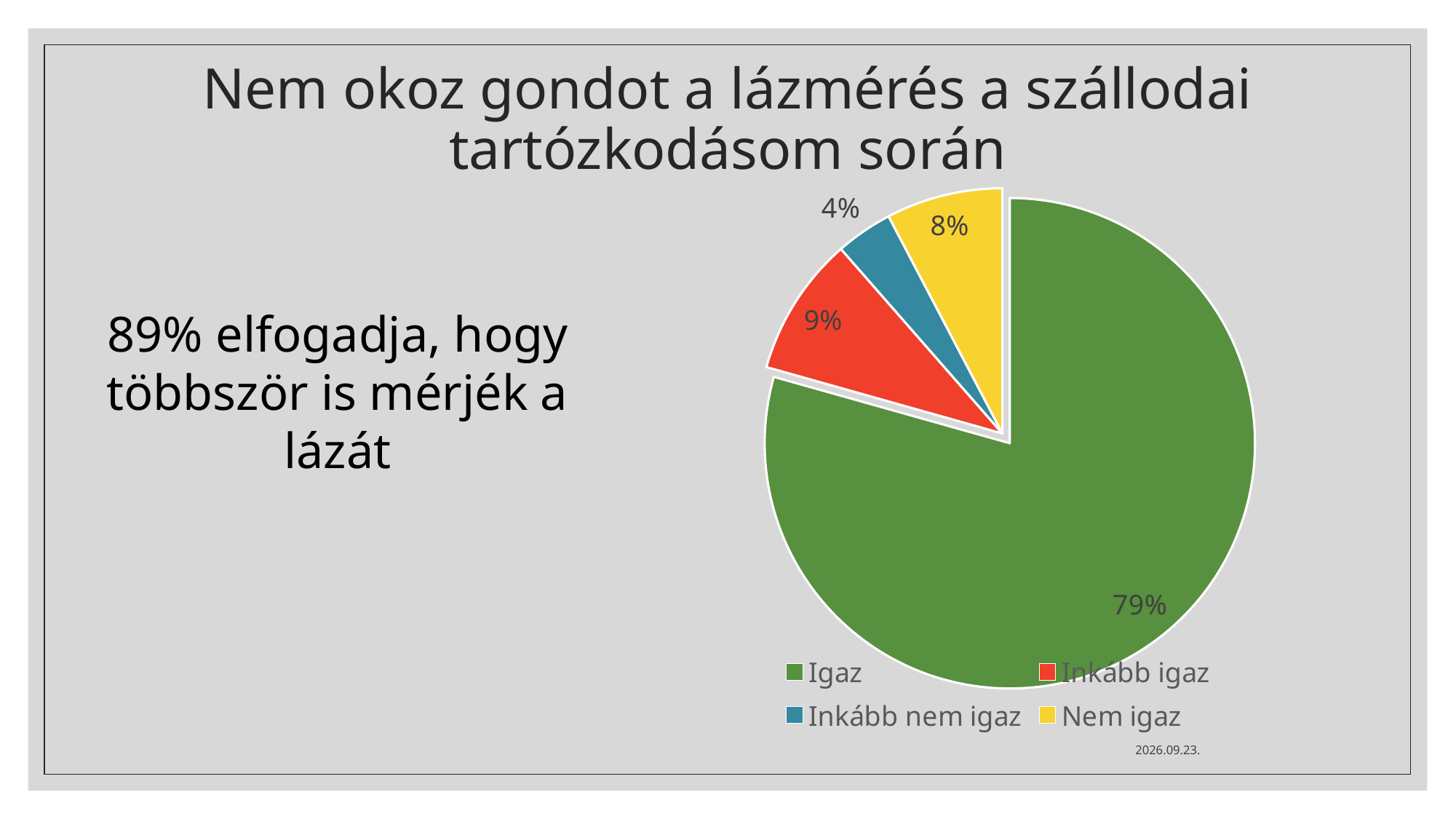
What is the difference in percentage points between the "Igaz" slice and the "Inkább igaz" slice? 70 What kind of chart is shown on the slide? pie chart What percentage of the pie is the "Inkább nem igaz" slice? 4% What colour is the "Nem igaz" slice in the pie chart? yellow What percentage of the pie is the "Igaz" slice? 79% Which category has the smallest slice of the pie? Inkább nem igaz What percentage of the pie is the "Inkább igaz" slice? 9% How many slices does the pie chart have? 4 Which category has the largest slice of the pie? Igaz What is the combined share of the "Igaz" and "Inkább igaz" slices? 88% Which slice is larger, "Nem igaz" or "Inkább nem igaz"? Nem igaz What percentage of the pie is the "Nem igaz" slice? 8%